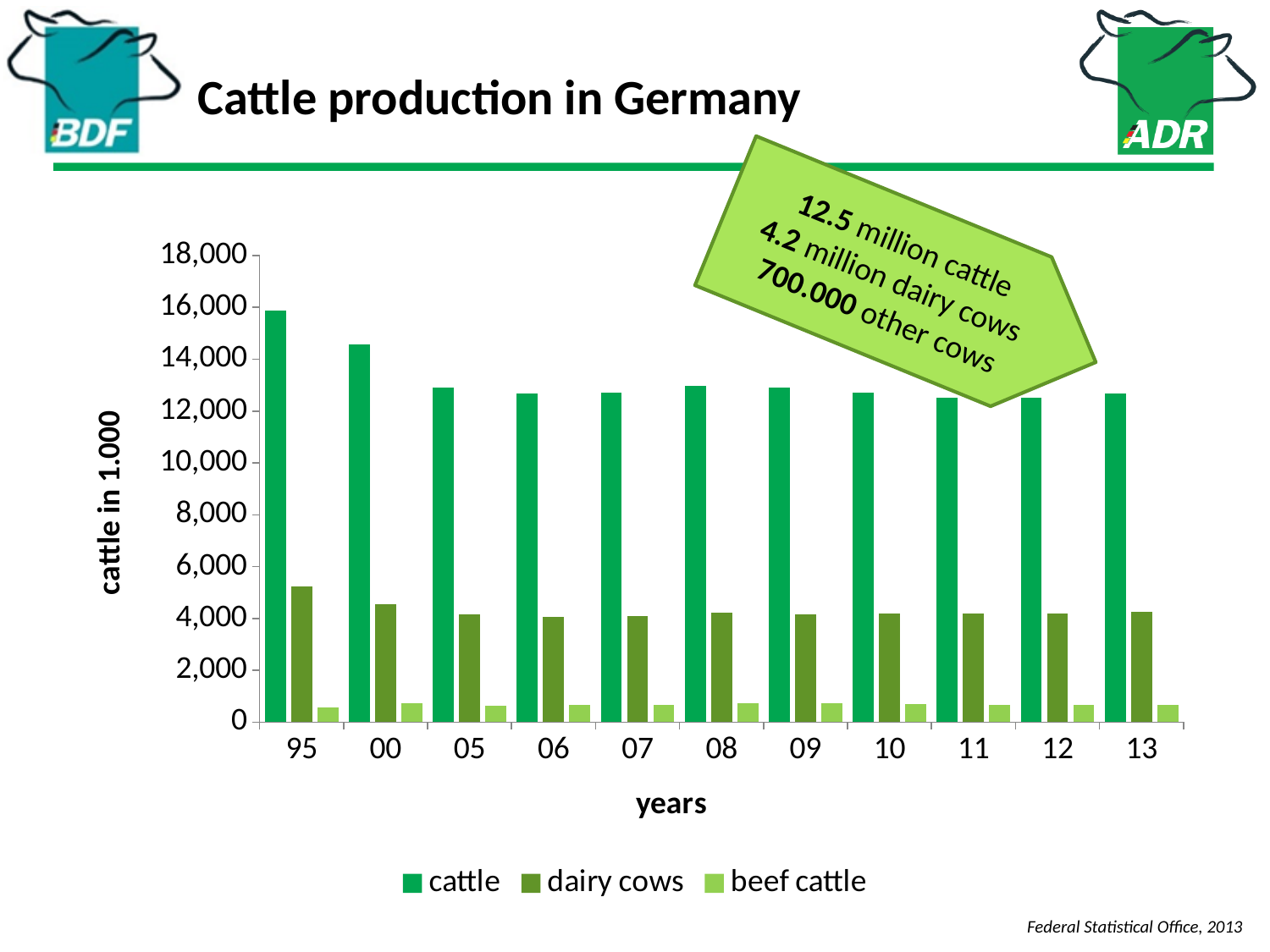
What is the title of the y axis? cattle in 1.000 Is the beef cattle value for 95 greater or less than 2,000? less Which is larger, the cattle value for 95 or for 00? 95 In which year is the dairy cows value highest? 95 Is the cattle value for 13 greater or less than 14,000? less What kind of chart is shown on the slide? bar chart In which year is the cattle value highest? 95 Does the cattle value rise or fall from 95 to 05? fall How many years are shown on the x axis? 11 Is the cattle value for 95 greater or less than 14,000? greater How many series does the legend list? 3